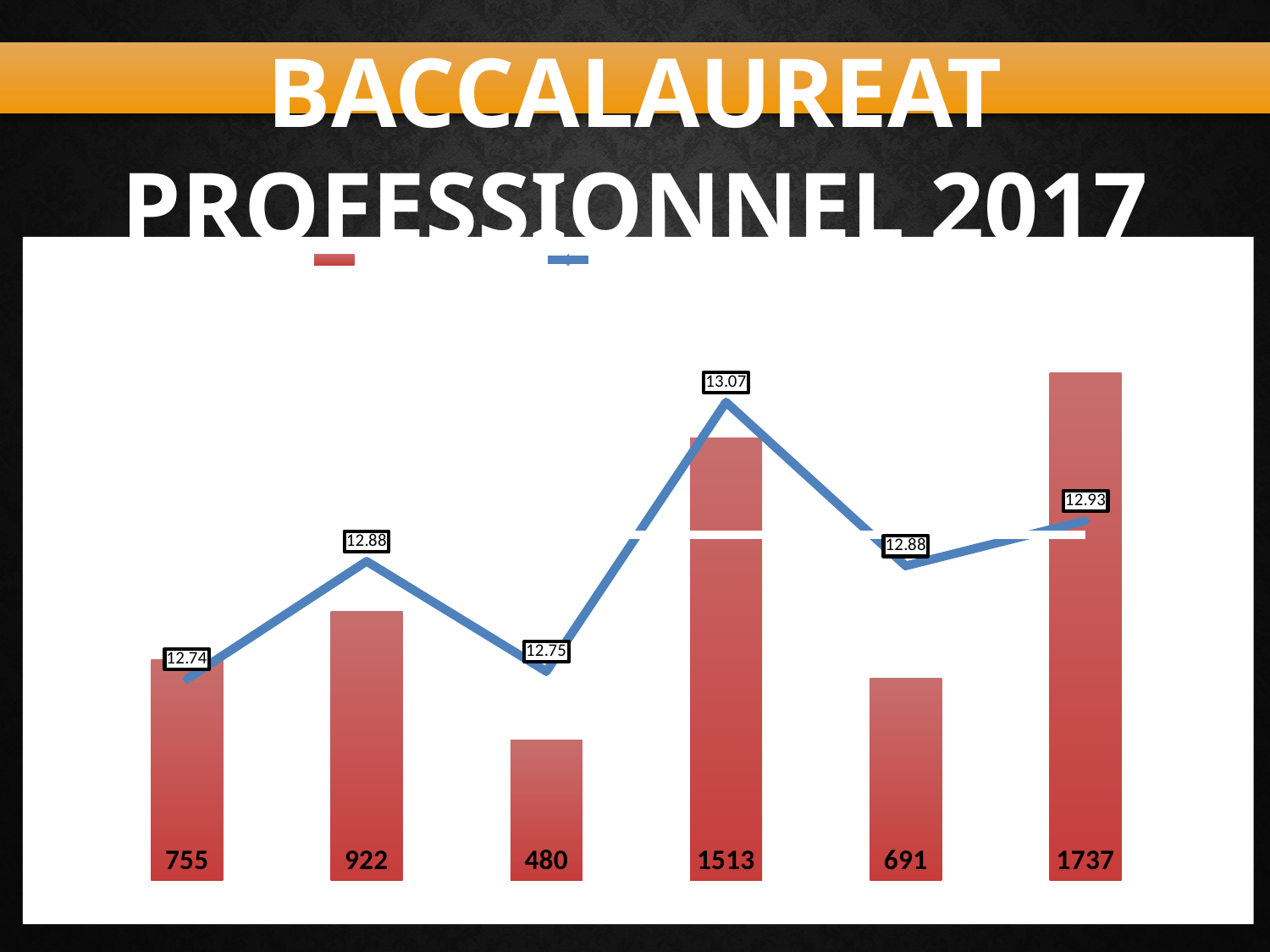
Which bar has the lowest value? The third bar, 480 What kind of chart is shown on the slide? A combined bar and line chart How many bars are plotted in the chart? 6 What is the value printed on the first bar from the left? 755 What is the line value labelled above the fourth point from the left? 13.07 What is the title of the slide containing the chart? BACCALAUREAT PROFESSIONNEL 2017 What is the value printed on the fourth bar from the left? 1513 Which is larger, the second bar's value or the fifth bar's value? The second bar (922) What is the line value labelled at the first point on the left? 12.74 What is the difference between the highest bar value (1737) and the lowest bar value (480)? 1257 Which bar has the highest value? The sixth (rightmost) bar, 1737